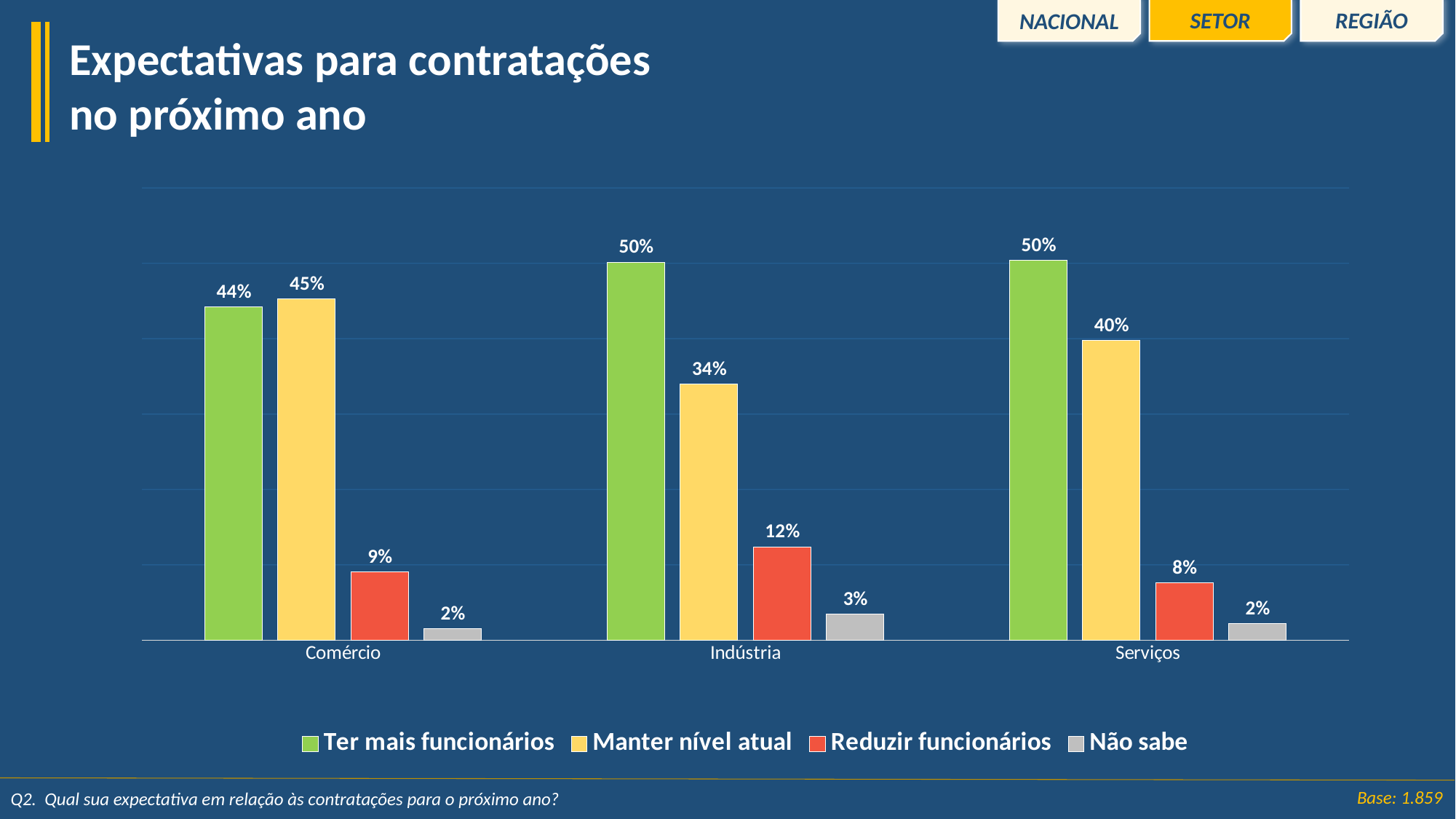
What is the value for "Não sabe" in the Indústria category? 3% How many series does the legend list? 4 What is the difference between "Ter mais funcionários" and "Manter nível atual" in the Serviços category? 10% Which category has the highest value for "Manter nível atual"? Comércio What is the value for "Ter mais funcionários" in the Comércio category? 44% Which category has the lowest value for "Reduzir funcionários"? Serviços Which is larger in the Comércio category: "Ter mais funcionários" or "Manter nível atual"? Manter nível atual What kind of chart is shown on the slide? Bar chart What is the value for "Manter nível atual" in the Indústria category? 34% Which colour represents "Reduzir funcionários" in the legend? Red What is the value for "Reduzir funcionários" in the Serviços category? 8% How many categories are shown on the x axis? 3